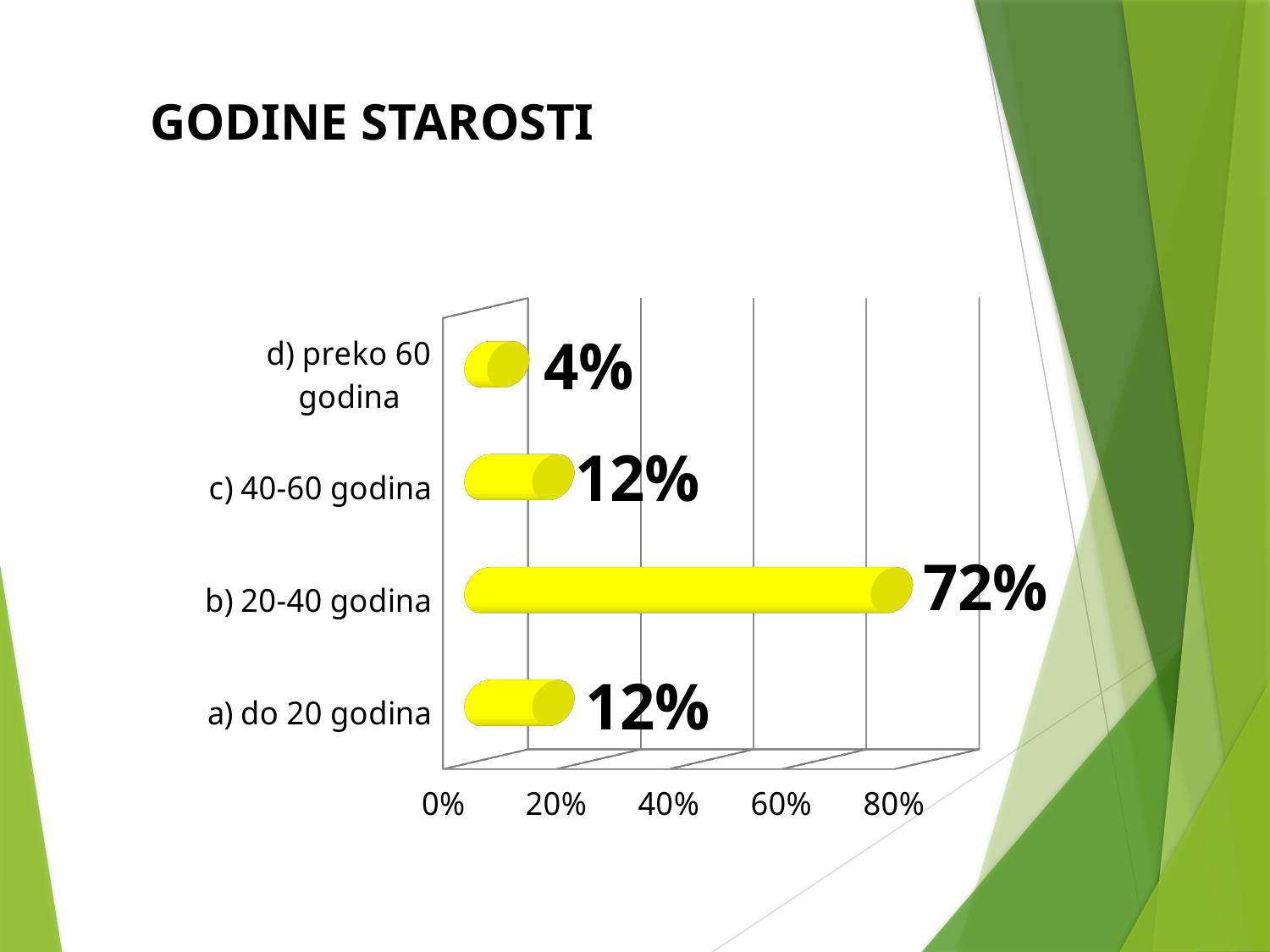
Which category has the highest value? b) 20-40 godina What is the value for "a) do 20 godina"? 12% What is the value for "d) preko 60 godina"? 4% What kind of chart is shown on the slide? bar chart Which category has the lowest value? d) preko 60 godina What is the title of the chart? GODINE STAROSTI Which is larger, the value for "c) 40-60 godina" or the value for "d) preko 60 godina"? c) 40-60 godina What is the difference between the values for "a) do 20 godina" and "d) preko 60 godina"? 8% How many categories are shown in the chart? 4 What is the difference between the values for "b) 20-40 godina" and "c) 40-60 godina"? 60% What is the value for "b) 20-40 godina"? 72% What is the value for "c) 40-60 godina"? 12%